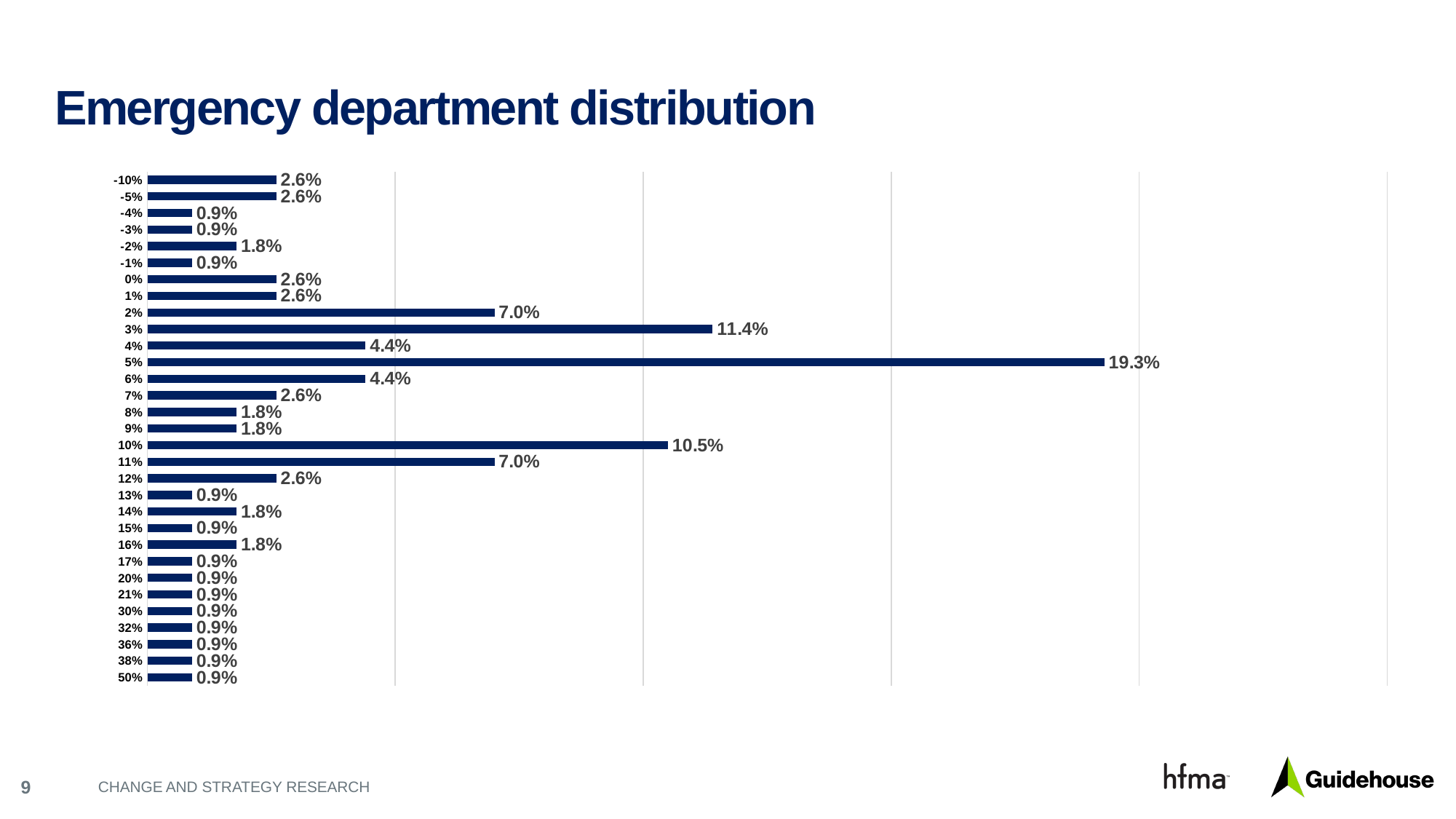
What kind of chart is shown on the slide? Bar chart What is the title of the slide? Emergency department distribution What is the difference between the values for the 10% and 11% categories? 3.5% What is the value for the 5% category? 19.3% What is the value for the 10% category? 10.5% How many categories are shown on the chart? 31 What is the value for the 14% category? 1.8% What is the value for the 3% category? 11.4% What is the value for the -10% category? 2.6% What is the difference between the values for the 5% and 3% categories? 7.9% Which category has the highest value? 5% Which has a larger value, the 2% category or the 4% category? 2%